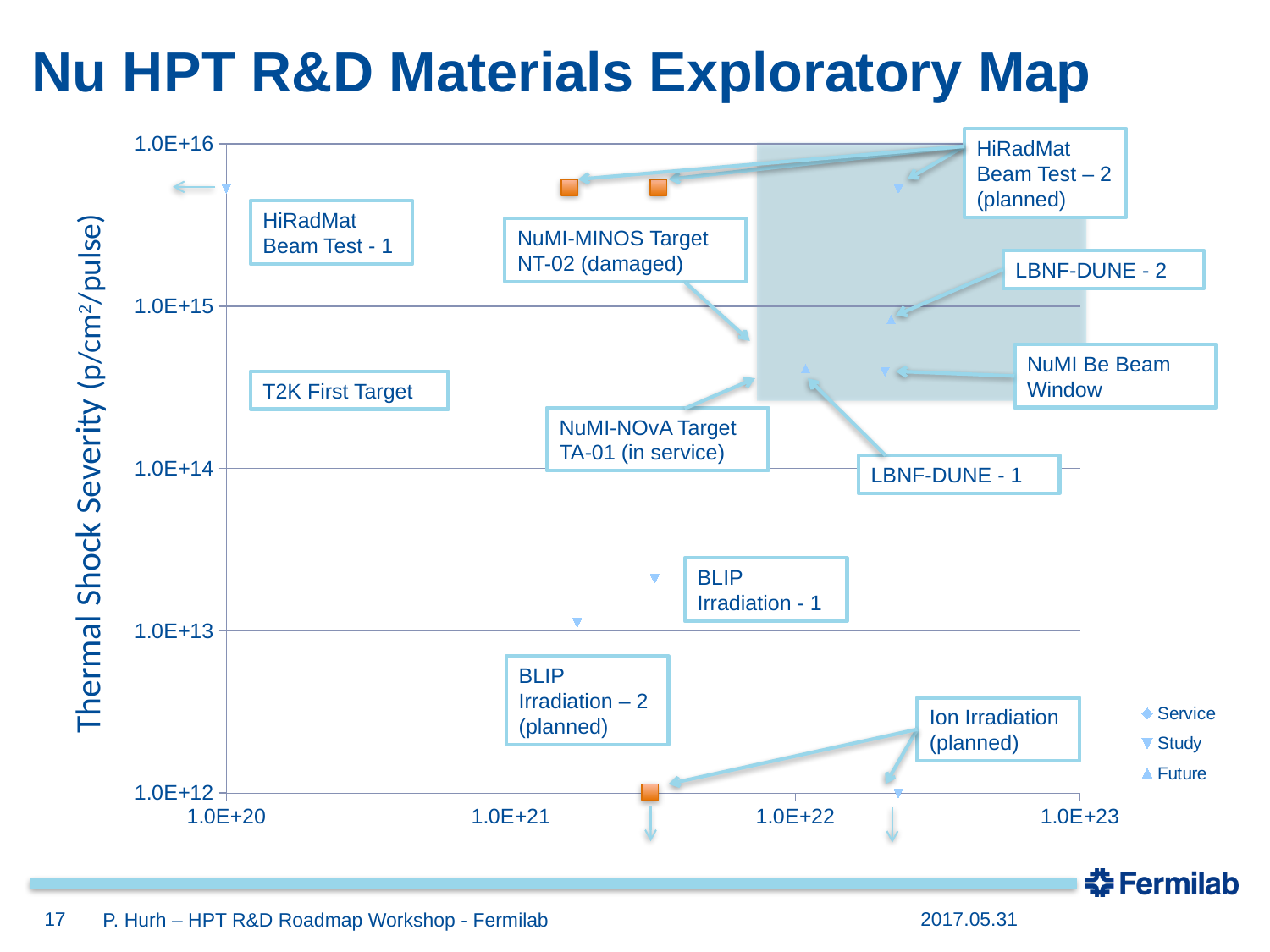
What kind of chart is shown on the slide? scatter chart What are the three series named in the chart legend? Service, Study, Future Is the thermal shock severity for BLIP Irradiation - 1 greater or less than 1.0E+14? less How many labelled data points or experiments are annotated on the chart? 11 Is the thermal shock severity for HiRadMat Beam Test - 1 greater or less than 1.0E+15? greater Is the thermal shock severity for BLIP Irradiation – 2 (planned) greater or less than 1.0E+14? less Which annotated experiment has the lowest thermal shock severity on the chart? Ion Irradiation (planned) Which has the higher thermal shock severity, HiRadMat Beam Test - 1 or BLIP Irradiation - 1? HiRadMat Beam Test - 1 How many series does the chart legend list? 3 What is the label of the vertical axis of the chart? Thermal Shock Severity (p/cm²/pulse)